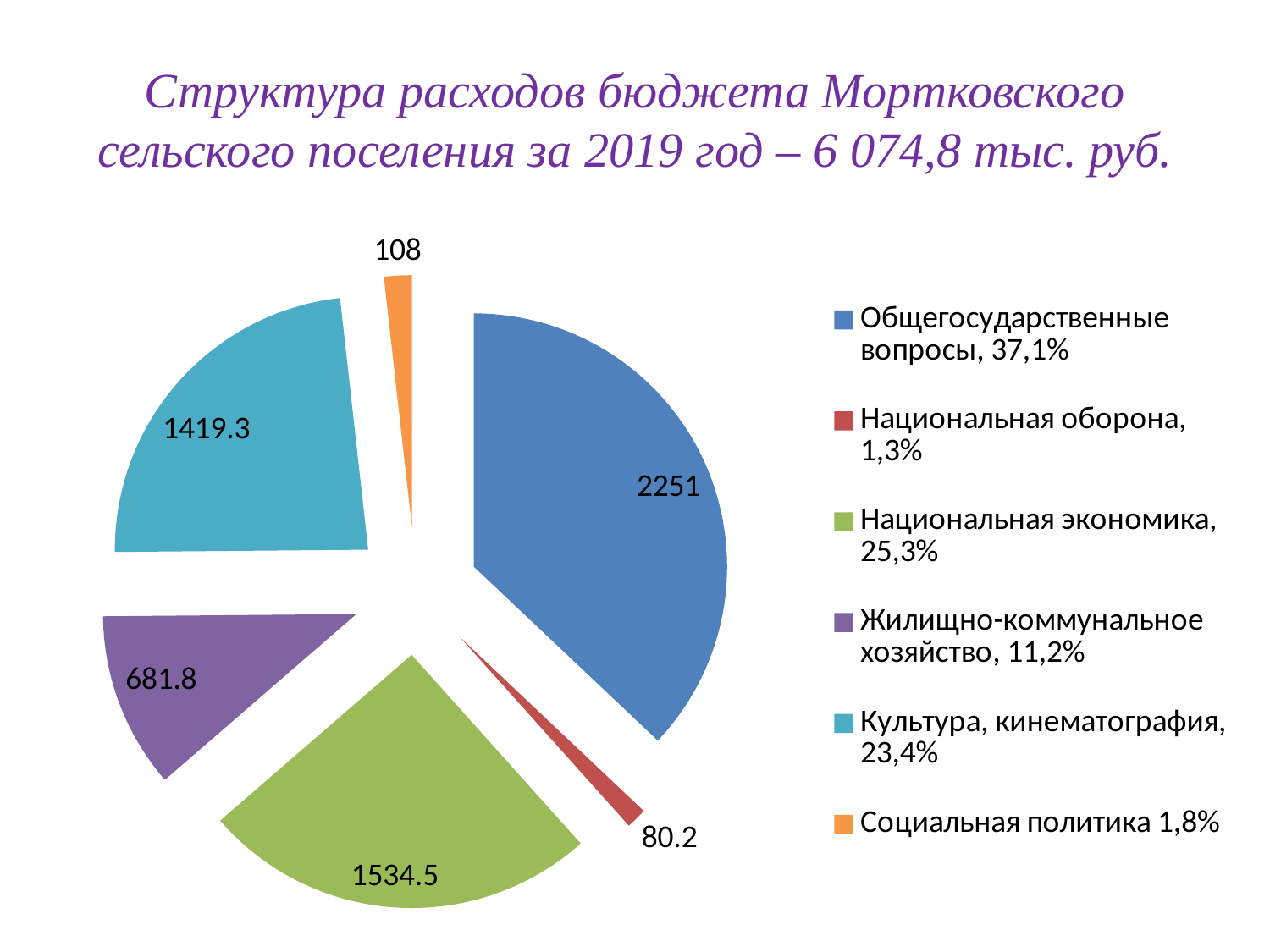
What share of the pie does Социальная политика represent, as shown in the legend? 1,8% What is the value for Национальная экономика? 1534.5 What is the value for Жилищно-коммунальное хозяйство? 681.8 What share of the pie does Культура, кинематография represent, as shown in the legend? 23,4% Which category has the largest slice of the pie? Общегосударственные вопросы What is the value for Культура, кинематография? 1419.3 What kind of chart is shown on the slide? pie chart How many categories does the legend list? 6 What is the value for Общегосударственные вопросы? 2251 Which is larger: the value for Социальная политика or the value for Национальная оборона? Социальная политика Which category has the smallest slice of the pie? Национальная оборона What is the difference between the values for Национальная экономика and Культура, кинематография? 115.2